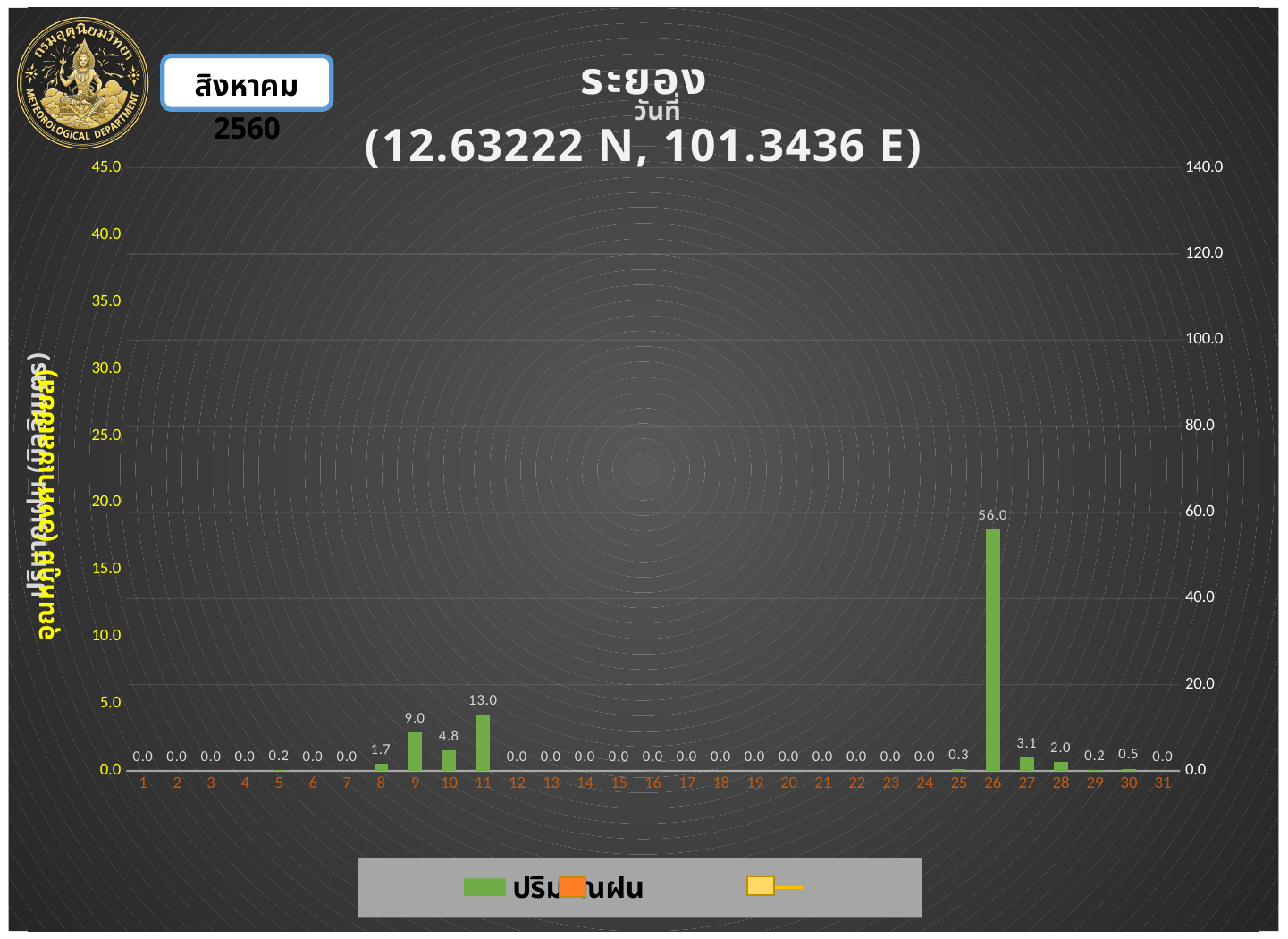
What is the value shown for day 10? 4.8 What kind of chart is shown on the slide? bar chart What is the difference between the values for day 26 and day 11? 43.0 What is the value shown for day 9? 9.0 Which day has the highest value? 26 What is the value shown for day 27? 3.1 How many days (categories) are shown on the x axis? 31 What is the rainfall value shown for day 26? 56.0 Which is larger, the value for day 8 or the value for day 28? day 28 What is the difference between the values for day 11 and day 9? 4.0 What are the coordinates given in the chart title? 12.63222 N, 101.3436 E What is the value shown for day 11? 13.0